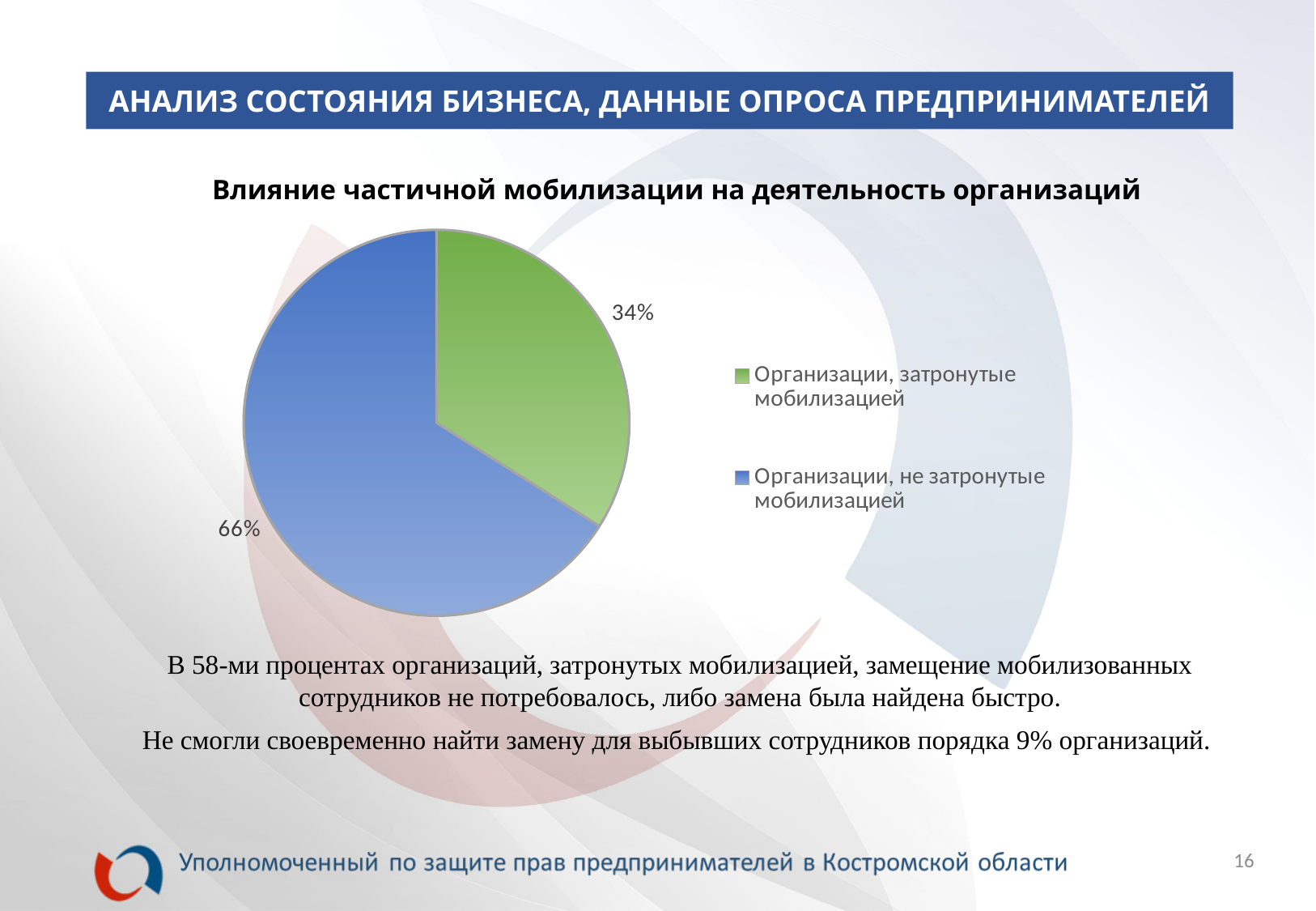
What is the title of the chart? Влияние частичной мобилизации на деятельность организаций What is the difference in percentage points between the slice for organizations not affected by mobilization and the slice for organizations affected by mobilization? 32 What kind of chart is shown on the slide? Pie chart What share of the pie is labelled for "Организации, не затронутые мобилизацией"? 66% How many slices does the pie chart have? 2 Which is larger: the slice for "Организации, затронутые мобилизацией" or the slice for "Организации, не затронутые мобилизацией"? Организации, не затронутые мобилизацией What is the total of the two percentages shown on the pie chart? 100% Which category has the largest slice of the pie? Организации, не затронутые мобилизацией Which category has the smallest slice of the pie? Организации, затронутые мобилизацией What colour is the slice for "Организации, затронутые мобилизацией"? Green How many entries does the legend list? 2 What share of the pie is labelled for "Организации, затронутые мобилизацией"? 34%